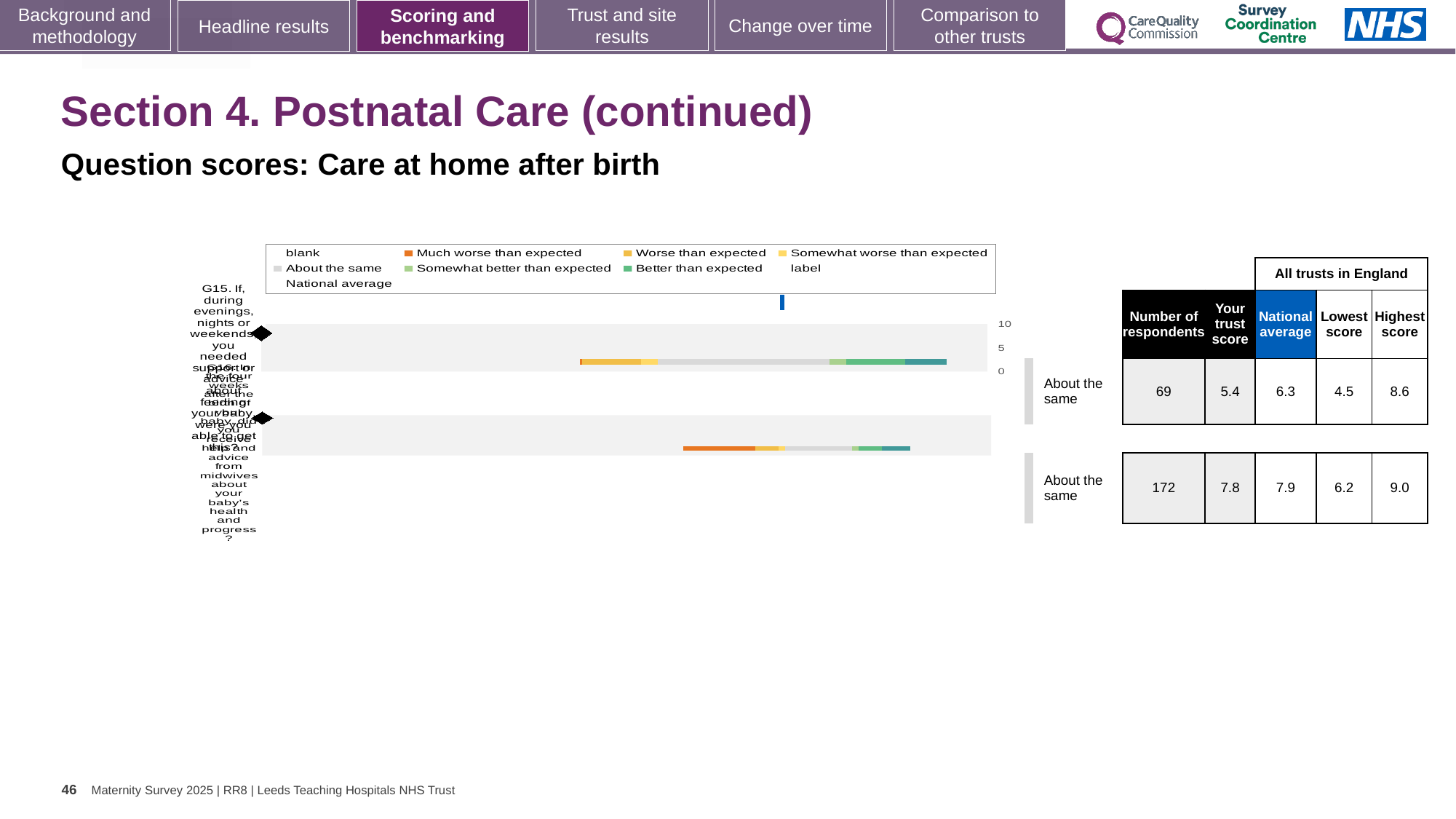
What is the number of respondents for the first (top) question row? 69 What is the difference between the highest and lowest scores for the first (top) question row? 4.1 What is the lowest score among all trusts in England for the first (top) question row? 4.5 What is the trust score for the first (top) question row? 5.4 For the first (top) question row, which is larger: the trust score or the national average? national average What is the national average for the second (bottom) question row? 7.9 What is the highest score among all trusts in England for the second (bottom) question row? 9.0 What kind of chart is shown on the slide? bar chart How many survey questions (rows) are plotted in the chart? 2 What benchmark category is shown for both question rows? About the same What is the difference in number of respondents between the second (bottom) row and the first (top) row? 103 Which question row has more respondents, the first (top) or the second (bottom)? second (bottom)